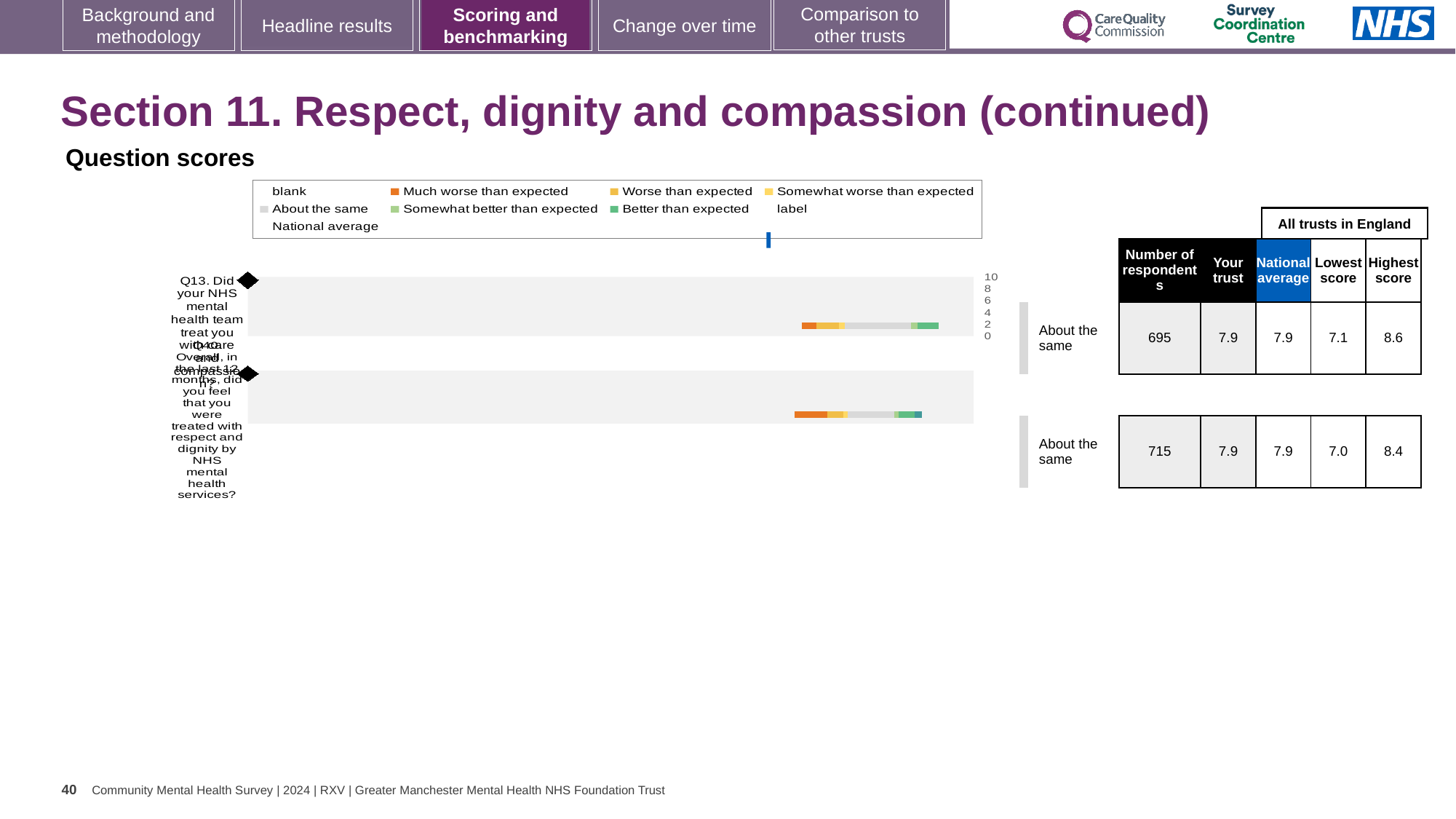
What is the lowest score among all trusts in England for Q13? 7.1 What is the 'Your trust' score for Q13? 7.9 What is the number of respondents for Q13? 695 What is the highest score among all trusts in England for Q14? 8.4 What is the difference between the highest and lowest scores for Q14? 1.4 What kind of chart is shown under 'Question scores'? bar chart What is the number of respondents for Q14? 715 How many questions (categories) are plotted in the chart? 2 What benchmark category is shown for the trust's score on Q13? About the same Which question has the higher highest score across all trusts in England, Q13 or Q14? Q13 Which question has more respondents, Q13 or Q14? Q14 What is the national average score for Q14? 7.9